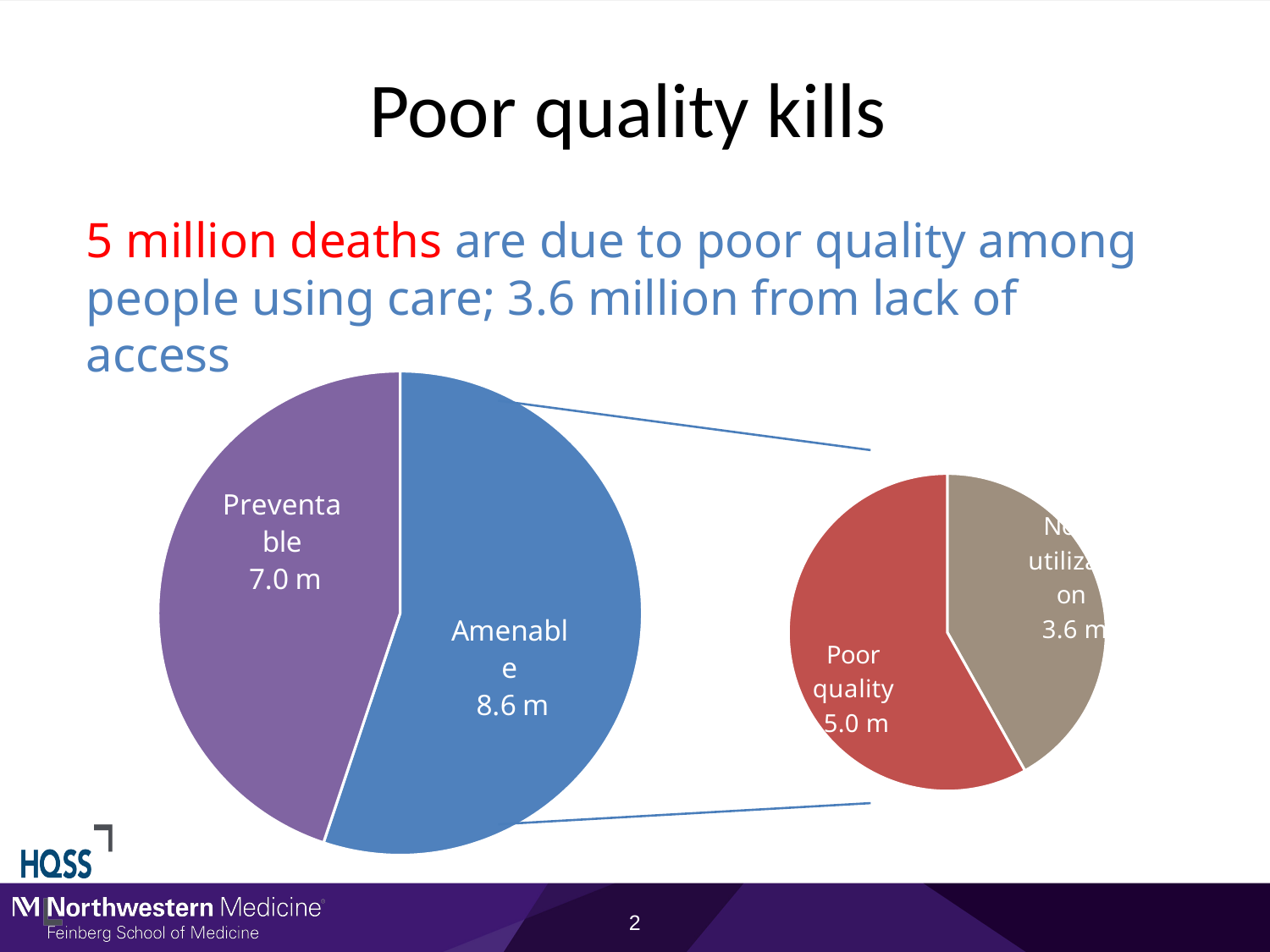
In the larger pie, which slice is the largest? Amenable How many slices does the larger pie have? 2 In the smaller pie, what is the difference between the Poor quality slice and the 3.6 m slice? 1.4 m In the larger pie, what is the value for Amenable? 8.6 m What is the total of the two slices in the larger pie? 15.6 m What is the total of the two slices in the smaller pie? 8.6 m What colour is the Amenable slice in the larger pie? blue In the larger pie, what is the difference between Amenable and Preventable? 1.6 m In the smaller pie, which is larger: the Poor quality slice or the 3.6 m slice? Poor quality What kind of chart is shown on the slide? pie chart In the smaller pie, what is the value for Poor quality? 5.0 m In the larger pie, what is the value for Preventable? 7.0 m